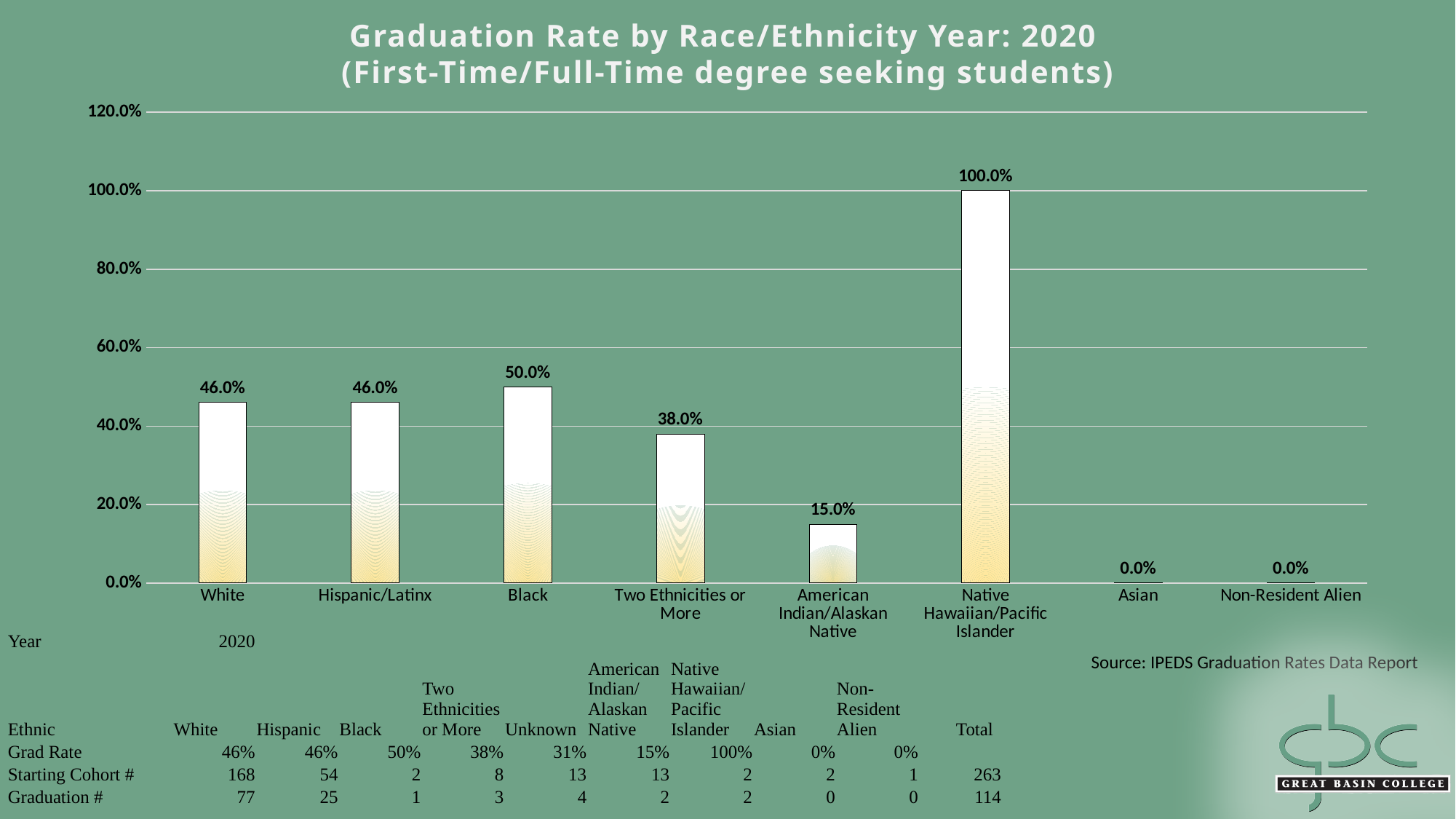
Which is larger, the graduation rate for Black students or for Hispanic/Latinx students? Black Which race/ethnicity category has the highest graduation rate in the chart? Native Hawaiian/Pacific Islander How many race/ethnicity categories are plotted on the x axis of the chart? 8 What is the title of the chart? Graduation Rate by Race/Ethnicity Year: 2020 (First-Time/Full-Time degree seeking students) What is the difference between the graduation rate for Native Hawaiian/Pacific Islander and the rate for Black students? 50.0% What is the graduation rate shown for American Indian/Alaskan Native students? 15.0% Is the graduation rate for Two Ethnicities or More greater or less than 40.0%? less What is the graduation rate shown for Black students? 50.0% What kind of chart is shown on the slide? bar chart What is the difference between the graduation rate for White students and the rate for Two Ethnicities or More? 8.0% What graduation rate is shown for Asian students in the chart? 0.0% What is the graduation rate shown for Two Ethnicities or More? 38.0%